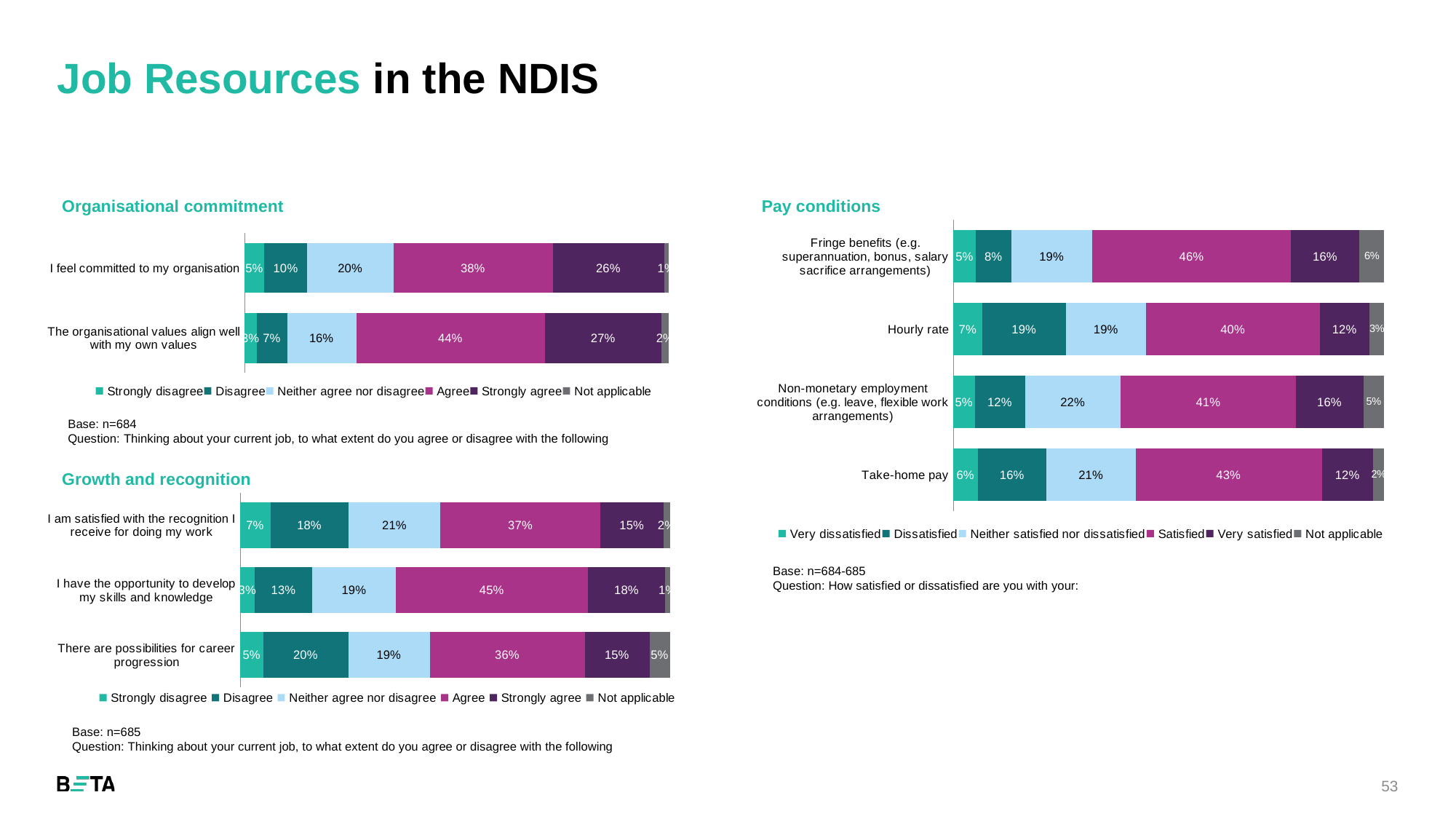
In the Growth and recognition chart, which statement has the highest Disagree percentage? There are possibilities for career progression In the Pay conditions chart, what is the difference between the Satisfied percentages for Take-home pay and Hourly rate? 3% In the Organisational commitment chart, what percentage Agree that they feel committed to their organisation? 38% In the Pay conditions chart, which item has the highest Satisfied percentage? Fringe benefits (e.g. superannuation, bonus, salary sacrifice arrangements) What type of chart is the Growth and recognition chart? Stacked bar chart In the Pay conditions chart, what percentage are Dissatisfied with their Hourly rate? 19% In the Growth and recognition chart, is the Agree percentage larger for 'I am satisfied with the recognition I receive for doing my work' or for 'There are possibilities for career progression'? I am satisfied with the recognition I receive for doing my work In the Organisational commitment chart, what percentage Strongly agree that the organisational values align well with their own values? 27% In the Pay conditions chart, what percentage of respondents are Satisfied with their Fringe benefits? 46% In the Growth and recognition chart, what percentage Agree that they have the opportunity to develop their skills and knowledge? 45% How many series does the legend of the Pay conditions chart list? 6 In the Pay conditions chart, which item has the lowest Very satisfied percentage? Hourly rate and Take-home pay (both 12%)